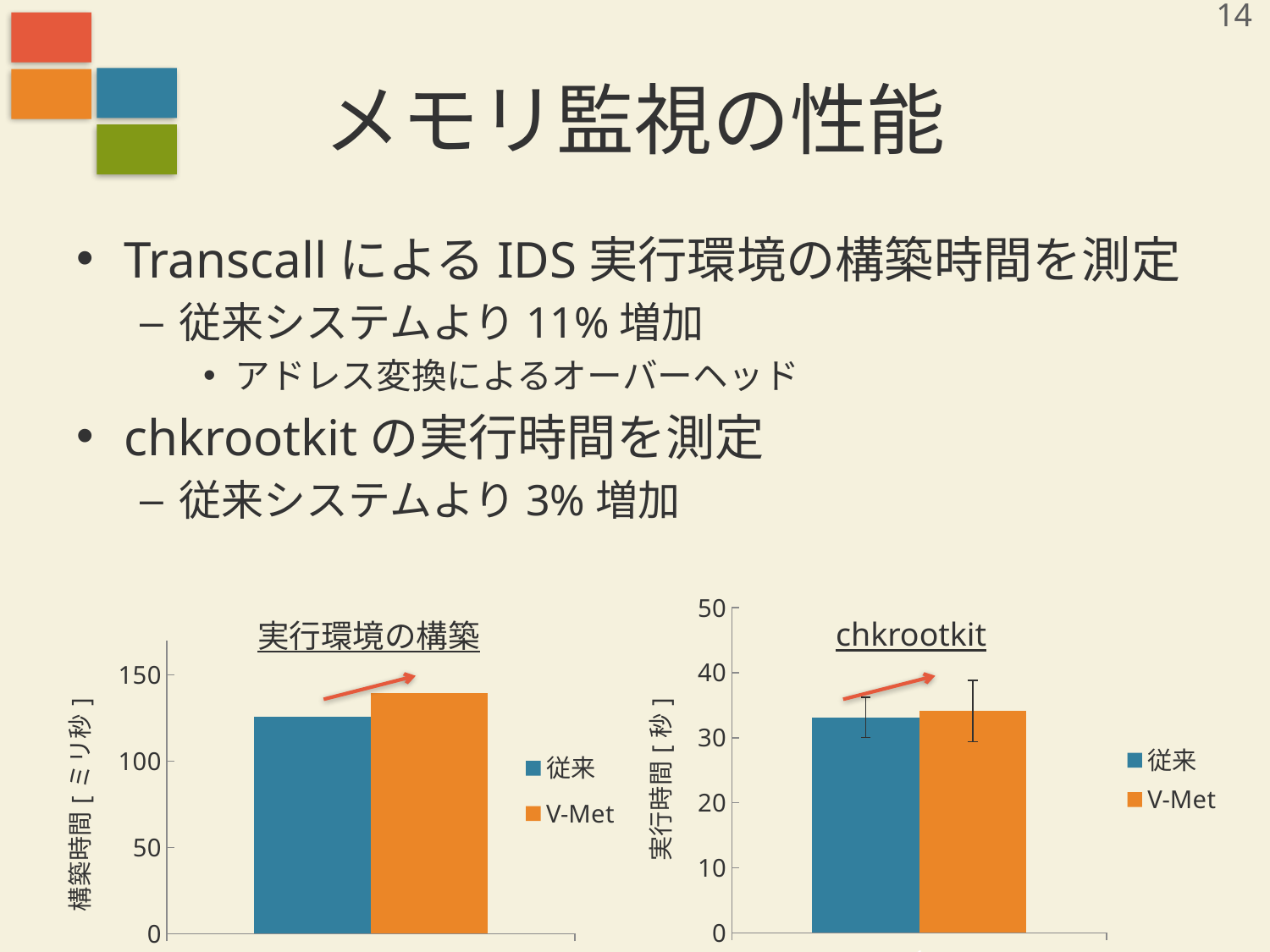
What is the y-axis label of the chart titled chkrootkit? 実行時間 [ 秒 ] In the chart titled chkrootkit, is the value for V-Met greater or less than 40? less What kind of chart is the chart titled chkrootkit? bar chart In the chart titled 実行環境の構築, is the value for 従来 greater or less than 100? greater In the chart titled 実行環境の構築, which series has the lowest bar? 従来 What kind of chart is the chart titled 実行環境の構築? bar chart In the chart titled 実行環境の構築, which series has the higher bar, 従来 or V-Met? V-Met What is the y-axis label of the chart titled 実行環境の構築? 構築時間 [ ミリ秒 ] In the chart titled chkrootkit, how many series does the legend list? 2 In the chart titled chkrootkit, is the value for 従来 greater or less than 30? greater In the chart titled 実行環境の構築, how many series does the legend list? 2